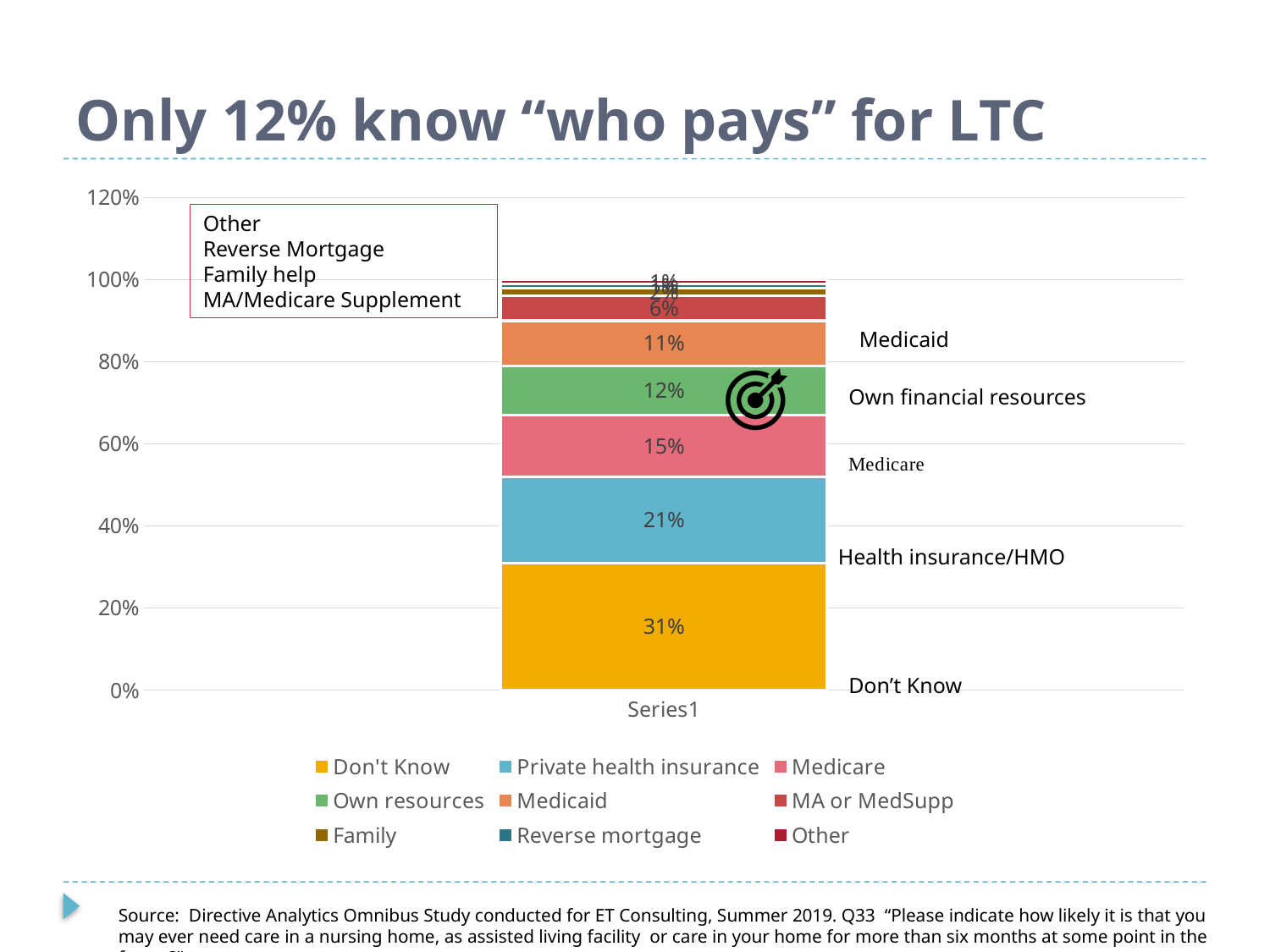
How many series does the legend list? 9 What value is shown for the Medicare segment? 15% What value is shown for the Private health insurance segment? 21% What percentage of the stacked bar is labelled for Don't Know? 31% Which segment of the stacked bar has the largest value? Don't Know What value is shown for the Medicaid segment? 11% Which is larger, the Medicare segment or the Medicaid segment? Medicare What is the label on the x axis under the bar? Series1 What kind of chart is shown on the slide? Stacked bar chart What is the difference between the Don't Know value and the Private health insurance value? 10% What value is shown for the MA or MedSupp segment? 6% What value is shown for the Own resources segment? 12%